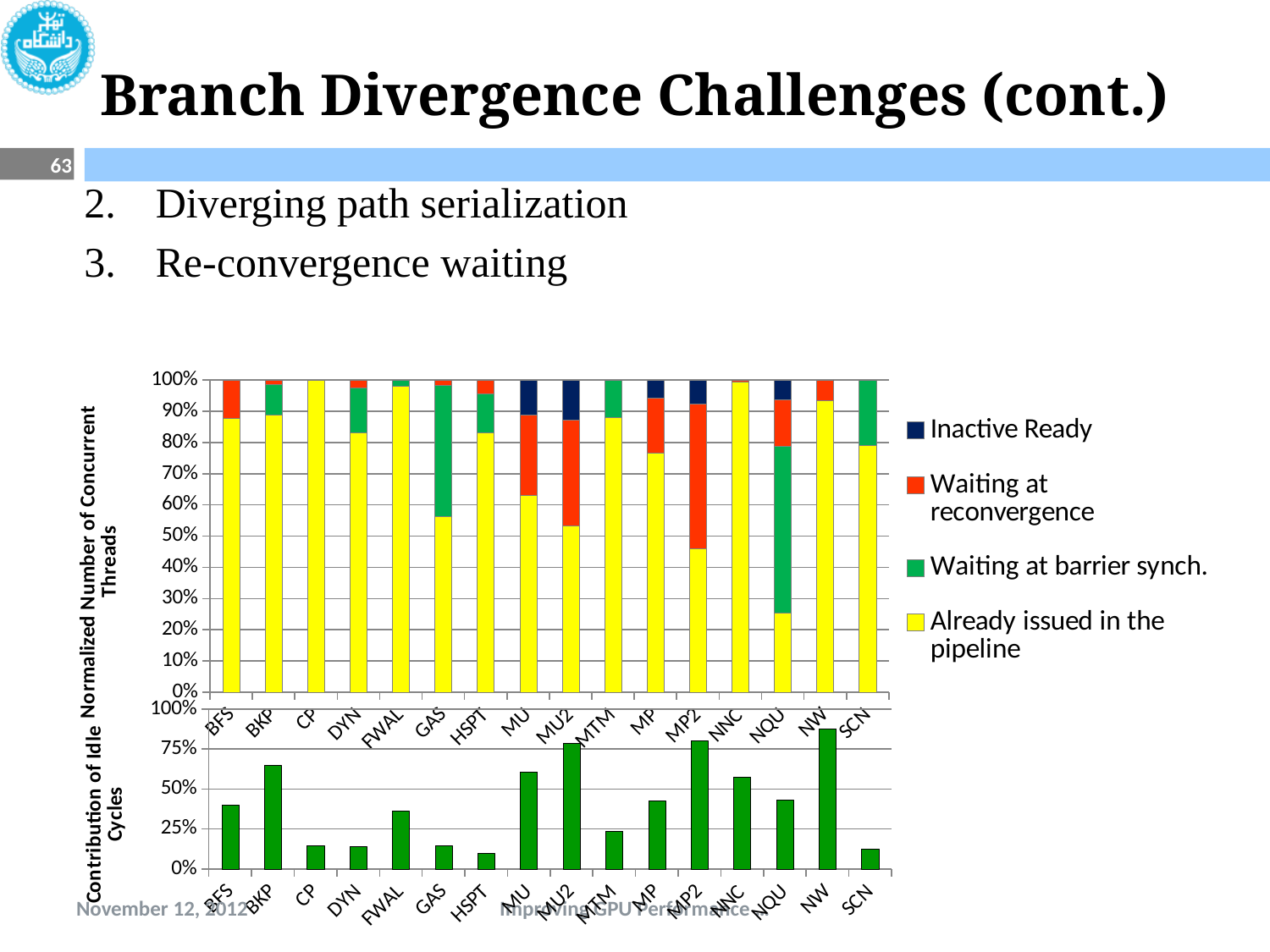
In the bottom chart, 'Contribution of Idle Cycles', is the value for BFS greater or less than 50%? less In the bottom chart, 'Contribution of Idle Cycles', which is larger, the value for MU2 or the value for MTM? MU2 In the bottom chart, 'Contribution of Idle Cycles', which benchmark has the highest value? NW In the top chart, 'Normalized Number of Concurrent Threads', which benchmark has a larger 'Already issued in the pipeline' share, GAS or HSPT? HSPT In the top chart, 'Normalized Number of Concurrent Threads', is the 'Already issued in the pipeline' share for NQU greater or less than 50%? less In the bottom chart, 'Contribution of Idle Cycles', is the value for CP greater or less than 25%? less What is the y-axis title of the top chart? Normalized Number of Concurrent Threads What kind of chart is the bottom chart, 'Contribution of Idle Cycles'? bar chart How many series does the legend of the top chart, 'Normalized Number of Concurrent Threads', list? 4 How many benchmark categories are shown on the x axis of the bottom chart, 'Contribution of Idle Cycles'? 16 In the top chart, 'Normalized Number of Concurrent Threads', which colour represents 'Waiting at reconvergence'? red